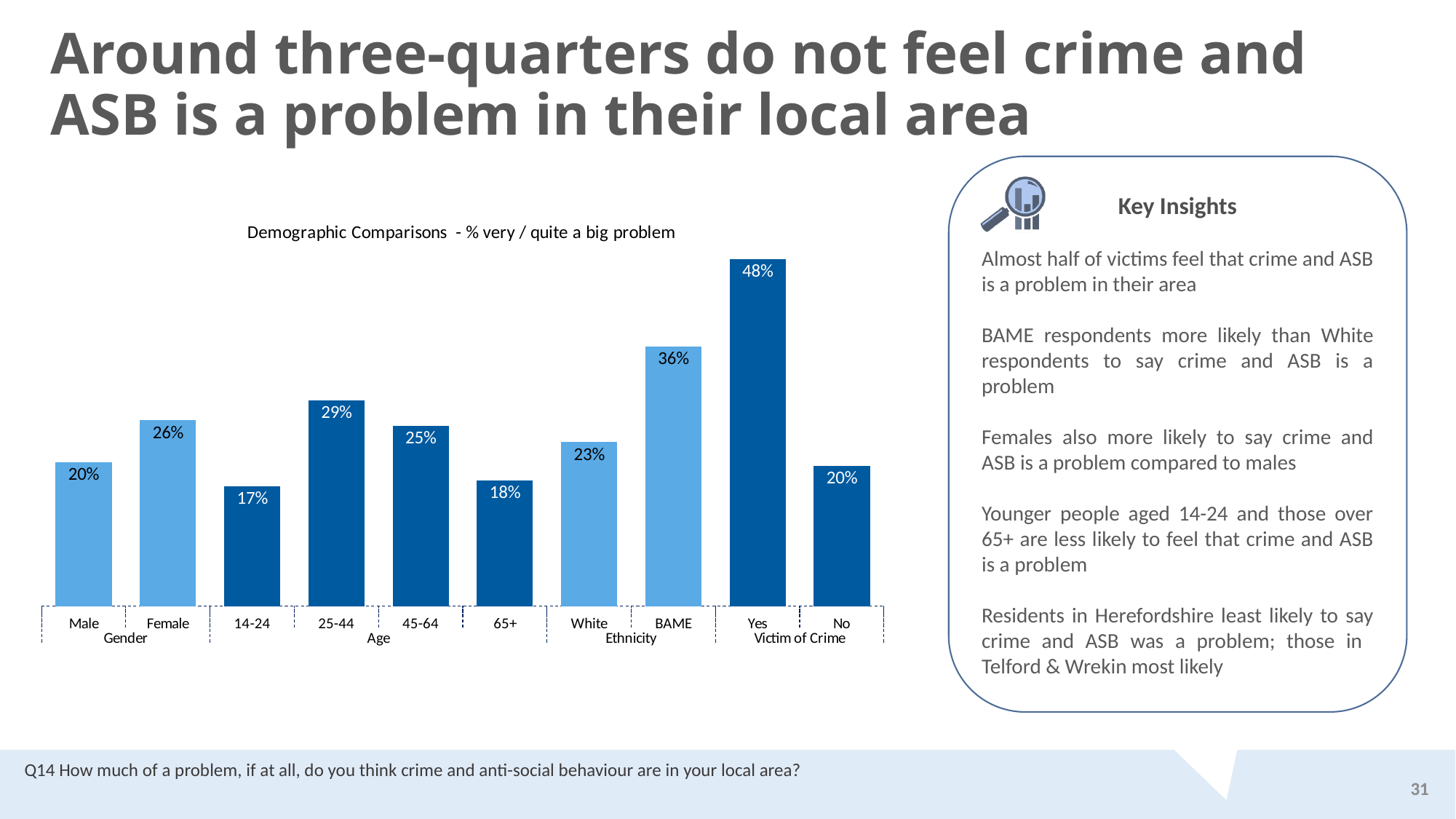
What kind of chart is shown on the slide? Bar chart How many bars are plotted in the chart? 10 Which is larger, the value for 25-44 or the value for 45-64? 25-44 What is the value for Female in the Demographic Comparisons chart? 26% How many demographic groups are labelled along the x axis of the chart? 4 What is the difference between the values for Yes and No under Victim of Crime? 28% What is the value for the 65+ age group? 18% What is the title of the chart? Demographic Comparisons - % very / quite a big problem What is the difference between the BAME and White values? 13% What percentage of BAME respondents say crime and ASB is a very / quite a big problem? 36% Which category has the highest value in the chart? Yes (Victim of Crime) Which category has the lowest value in the chart? 14-24